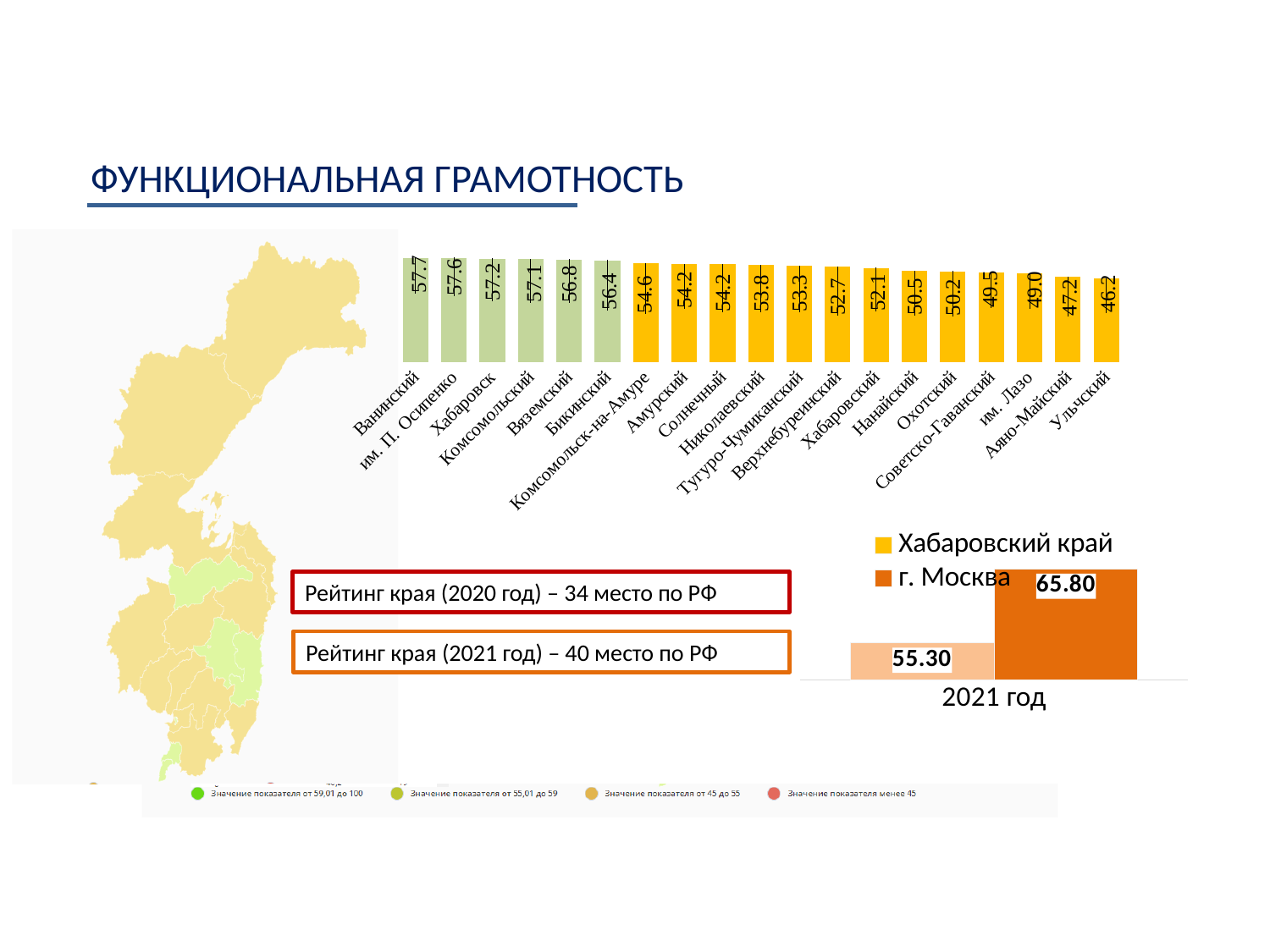
How many series does the legend of the bottom-right chart list? 2 In the bottom-right chart for 2021 год, what is the difference between г. Москва and Хабаровский край? 10.50 In the top bar chart of municipalities, which municipality has the highest value? Ванинский In the top bar chart of municipalities, what is the difference between the values for Ванинский and Ульчский? 11.5 In the top bar chart of municipalities, what is the value for Ванинский? 57.7 In the top bar chart of municipalities, do the values rise or fall from left to right? Fall What kind of chart is the top chart of municipalities? Bar chart In the top bar chart of municipalities, which municipality has the lowest value? Ульчский In the top bar chart of municipalities, how many municipalities are shown? 19 In the bottom-right chart for 2021 год, what is the value for Хабаровский край? 55.30 In the top bar chart of municipalities, which has the larger value, Бикинский or Комсомольск-на-Амуре? Бикинский In the top bar chart of municipalities, what is the value for Ульчский? 46.2